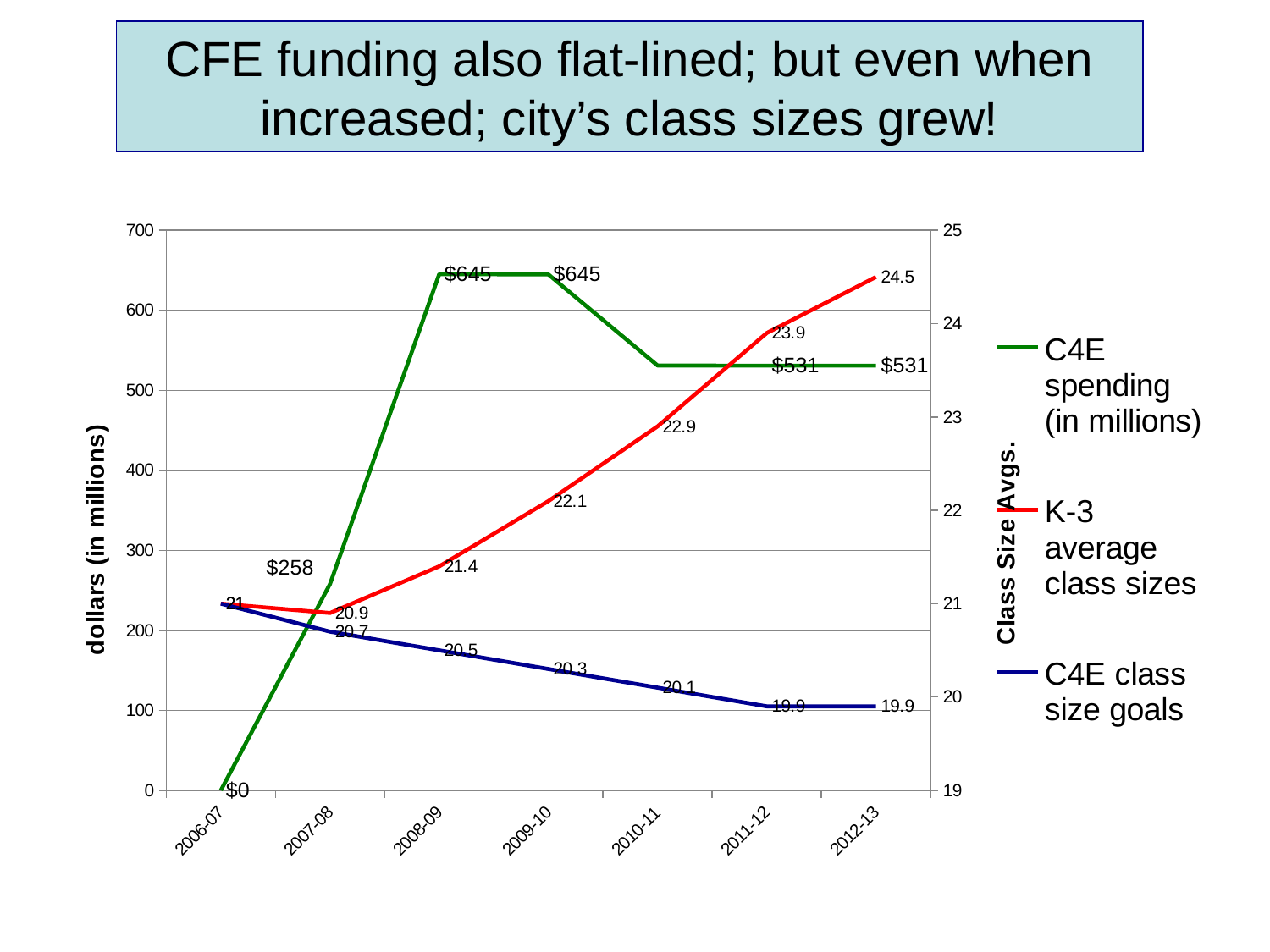
Does the K-3 average class size rise or fall from 2007-08 to 2012-13? rise What is the label of the right-hand vertical axis? Class Size Avgs. What is the difference between C4E spending in 2009-10 and in 2012-13? $114 How many school years are shown on the x axis? 7 What was the K-3 average class size in 2012-13? 24.5 How many series does the legend list? 3 Which is larger in 2011-12: the K-3 average class size or the C4E class size goal? K-3 average class size What was C4E spending (in millions) in 2008-09? $645 What type of chart is shown on the slide? line chart What was C4E spending (in millions) in 2007-08? $258 In which school year was the K-3 average class size lowest? 2007-08 What was the C4E class size goal in 2009-10? 20.3